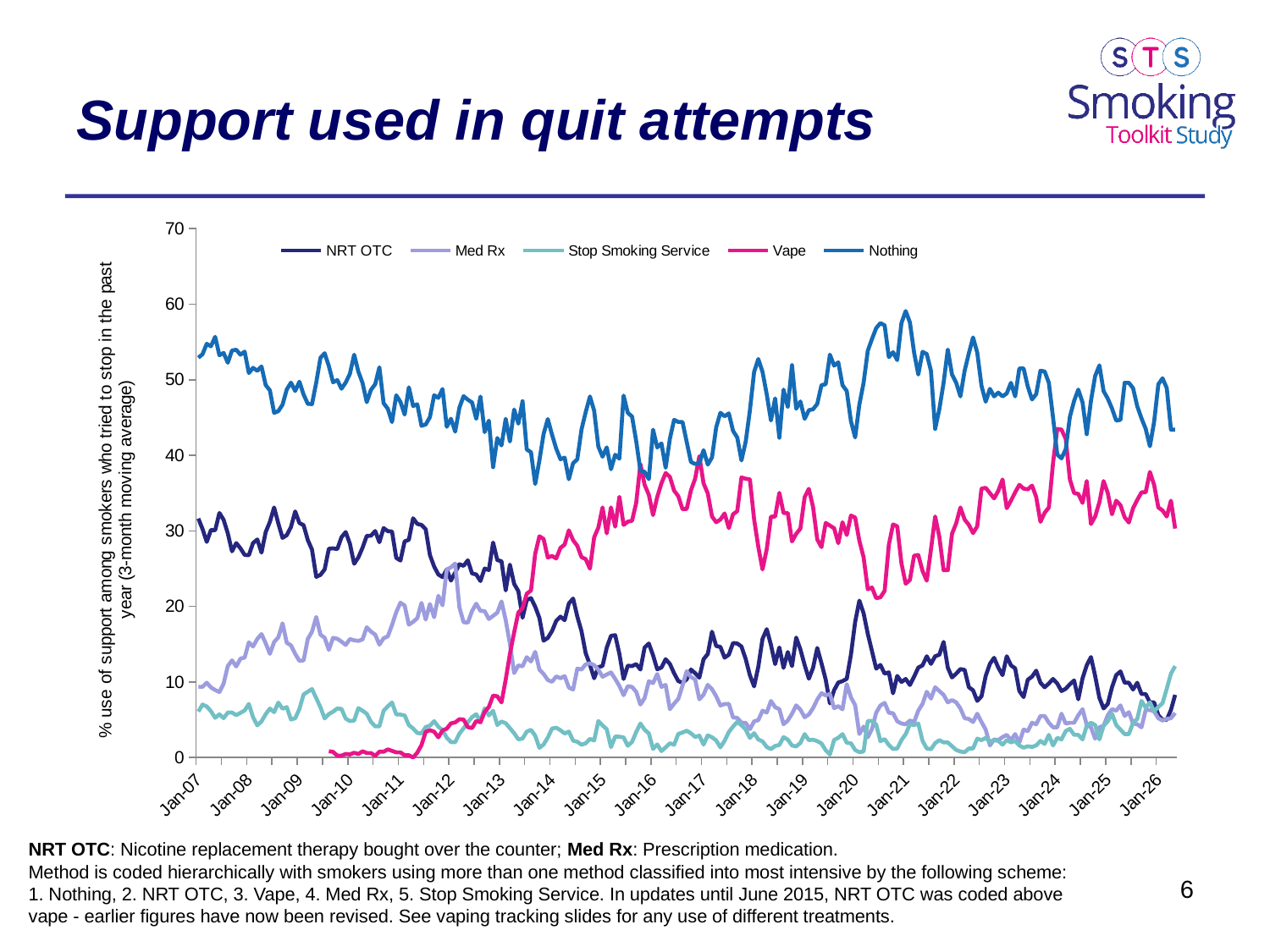
Which series has the highest values across most of the chart? Nothing Is the value for NRT OTC at Jan-07 greater or less than 20? greater At Jan-24, which series has the larger value, Vape or NRT OTC? Vape Does the NRT OTC line rise or fall overall from Jan-07 to Jan-26? fall Is the value for Vape at Jan-10 greater or less than 10? less What is the title of the chart on the slide? Support used in quit attempts Does the Vape line rise or fall between Jan-13 and Jan-16? rise How many series does the legend list? 5 Which series has the lowest values around Jan-22? Stop Smoking Service What kind of chart is shown on the slide? Line chart Is the value for Nothing at Jan-07 greater or less than 50? greater How many year labels are shown on the x axis? 20